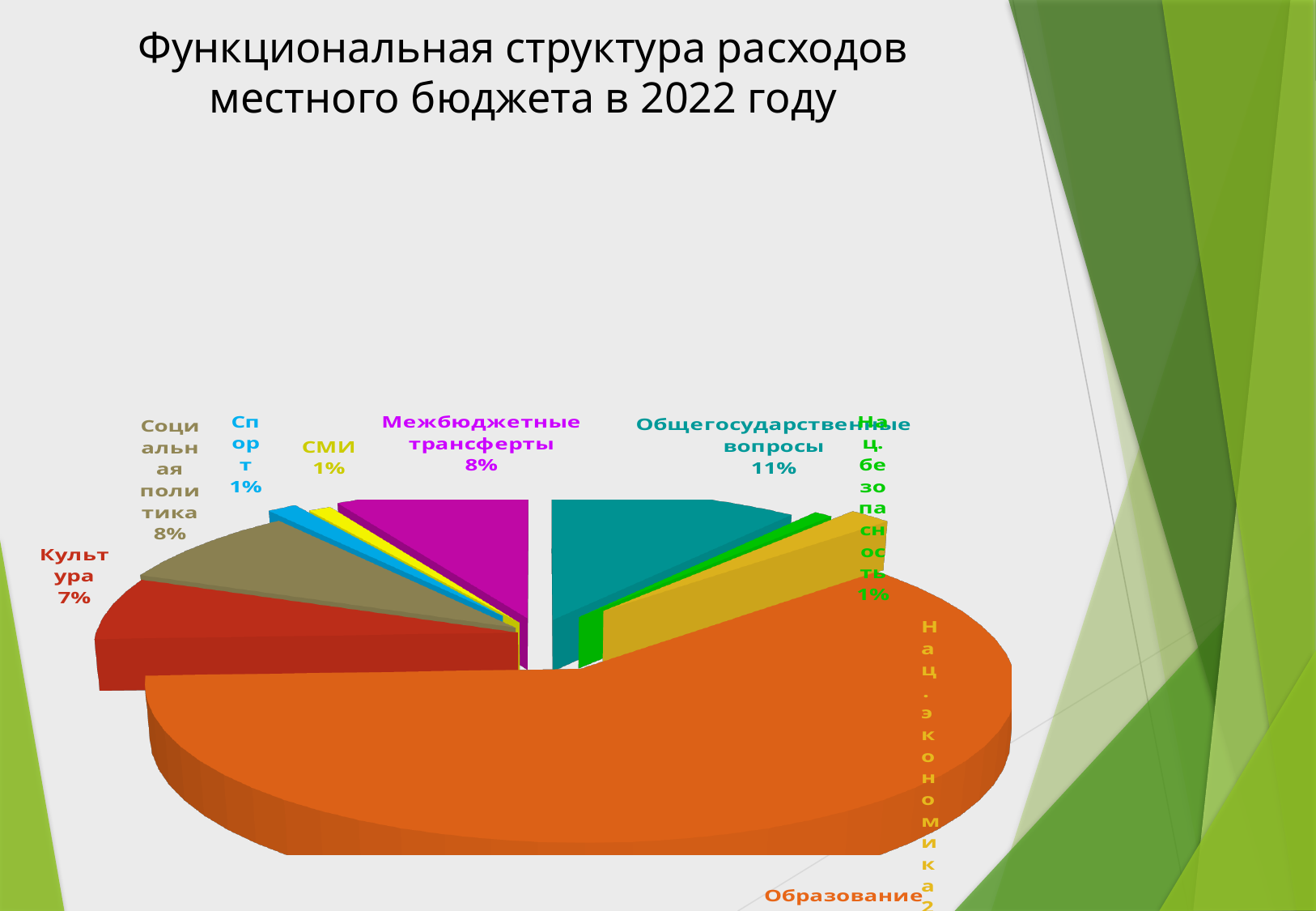
Which category has the largest slice of the pie? Образование Which is larger: Общегосударственные вопросы or Культура? Общегосударственные вопросы How many slices does the pie chart have? 9 What share of expenditures does СМИ account for? 1% What is the difference in percentage points between Общегосударственные вопросы and Культура? 4 What share of expenditures does Межбюджетные трансферты account for? 8% What is the title of the chart on the slide? Функциональная структура расходов местного бюджета в 2022 году What kind of chart is shown on the slide? pie chart What share of expenditures does Культура account for? 7%